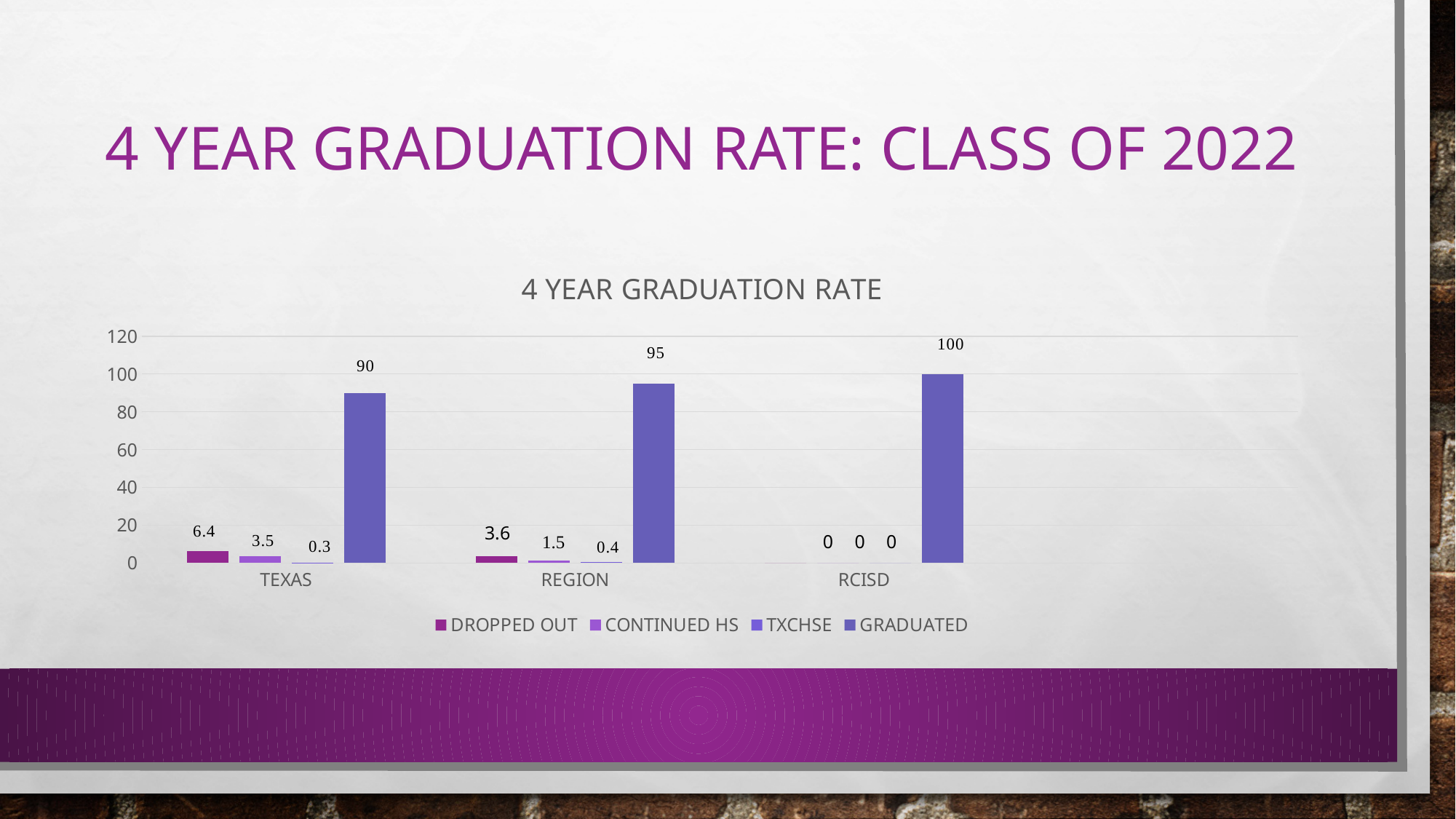
How many categories are shown on the x axis? 3 What is the Dropped Out value for Texas? 6.4 What is the Continued HS value for Region? 1.5 Which category has the lowest Graduated value? Texas What kind of chart is shown on the slide? Bar chart What is the Graduated value for RCISD? 100 How many series does the legend list? 4 What is the title of the chart? 4 Year Graduation Rate Which is larger, the Dropped Out value for Texas or for Region? Texas What is the difference between the Graduated values for Region and Texas? 5 What is the TXCHSE value for Texas? 0.3 Which category has the highest Graduated value? RCISD